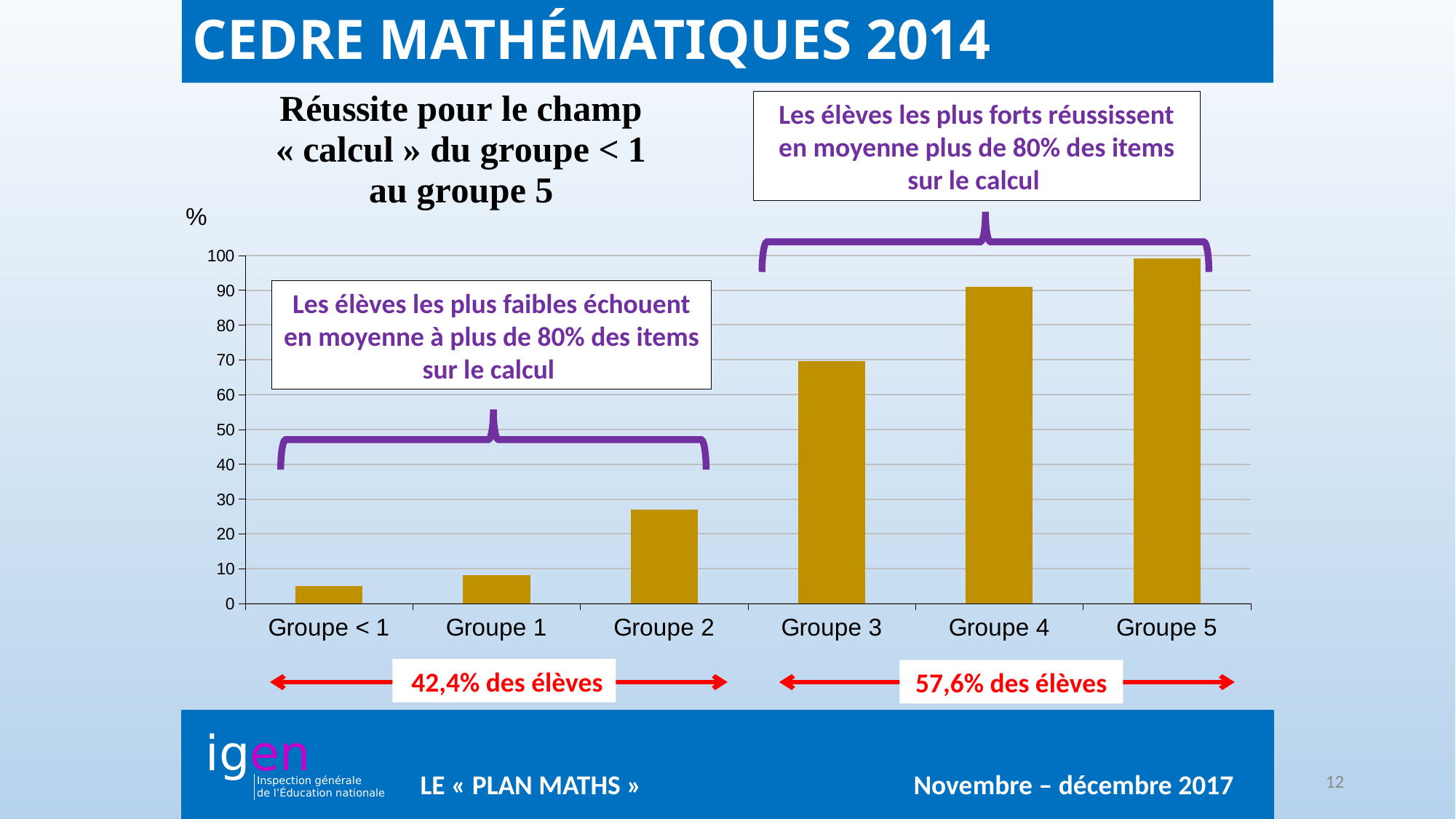
How many groups are plotted on the x axis of the chart? 6 Do the values rise or fall from Groupe < 1 to Groupe 5? rise Which is larger, the value for Groupe 3 or the value for Groupe 2? Groupe 3 What is the title of the chart? Réussite pour le champ « calcul » du groupe < 1 au groupe 5 Is the value for Groupe 1 greater or less than 10? less Which group has the highest bar in the chart? Groupe 5 Is the value for Groupe 2 greater or less than 20? greater What kind of chart is shown on the slide? bar chart Is the value for Groupe 4 greater or less than 80? greater Which group has the lowest bar in the chart? Groupe < 1